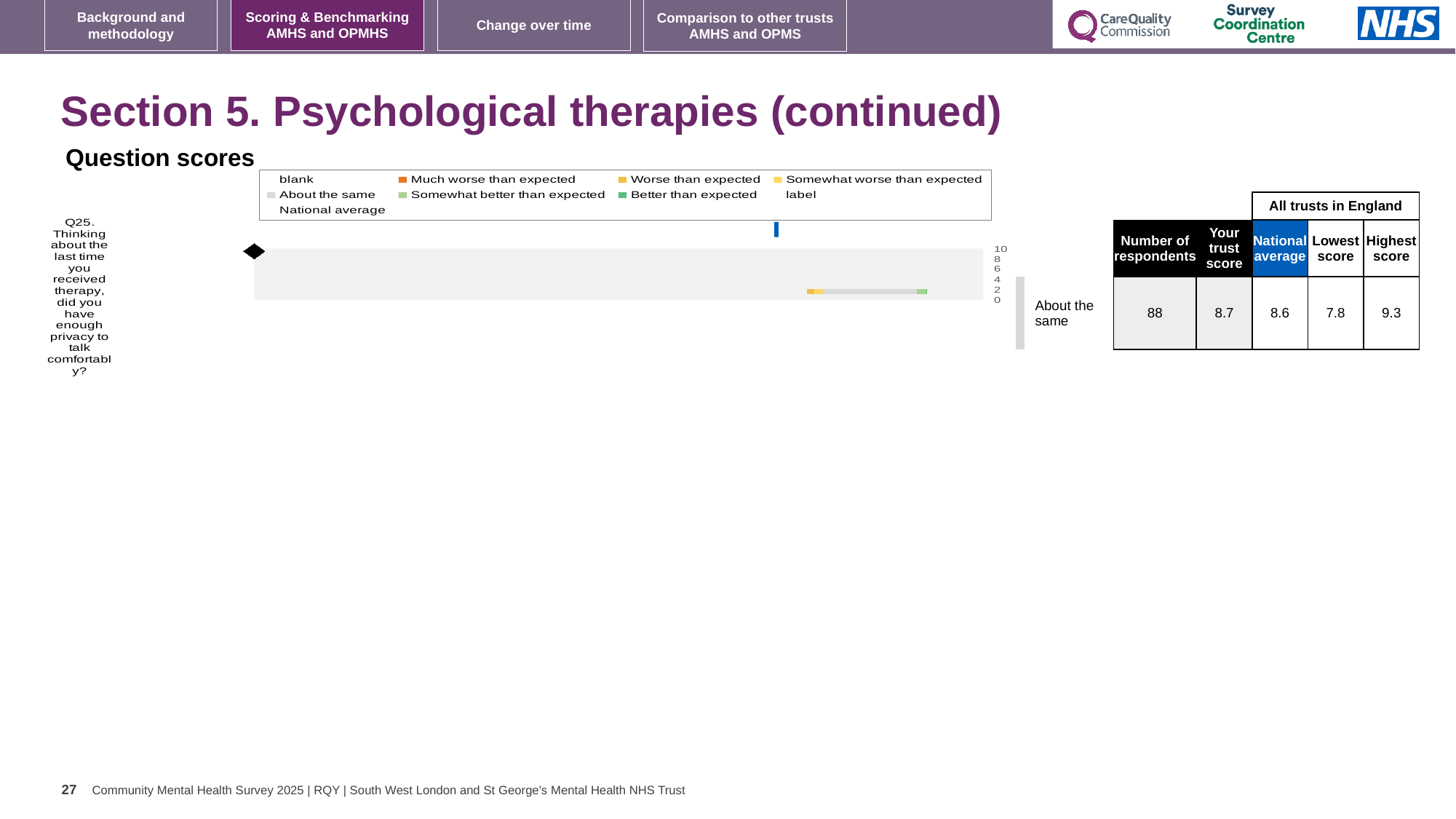
What kind of chart is shown under 'Question scores'? bar chart What is the difference between the highest and lowest scores for Q25? 1.5 What is the highest score among all trusts in England for Q25? 9.3 What colour does the legend use for 'Much worse than expected'? orange How many entries does the chart legend list? 9 What is the trust's score for Q25? 8.7 What is the lowest score among all trusts in England for Q25? 7.8 What is the number of respondents shown for Q25? 88 What is the national average score for Q25? 8.6 Which is larger for Q25, the trust score or the national average? trust score Which question number is plotted in the chart? Q25 How many questions (categories) are plotted in the chart? 1